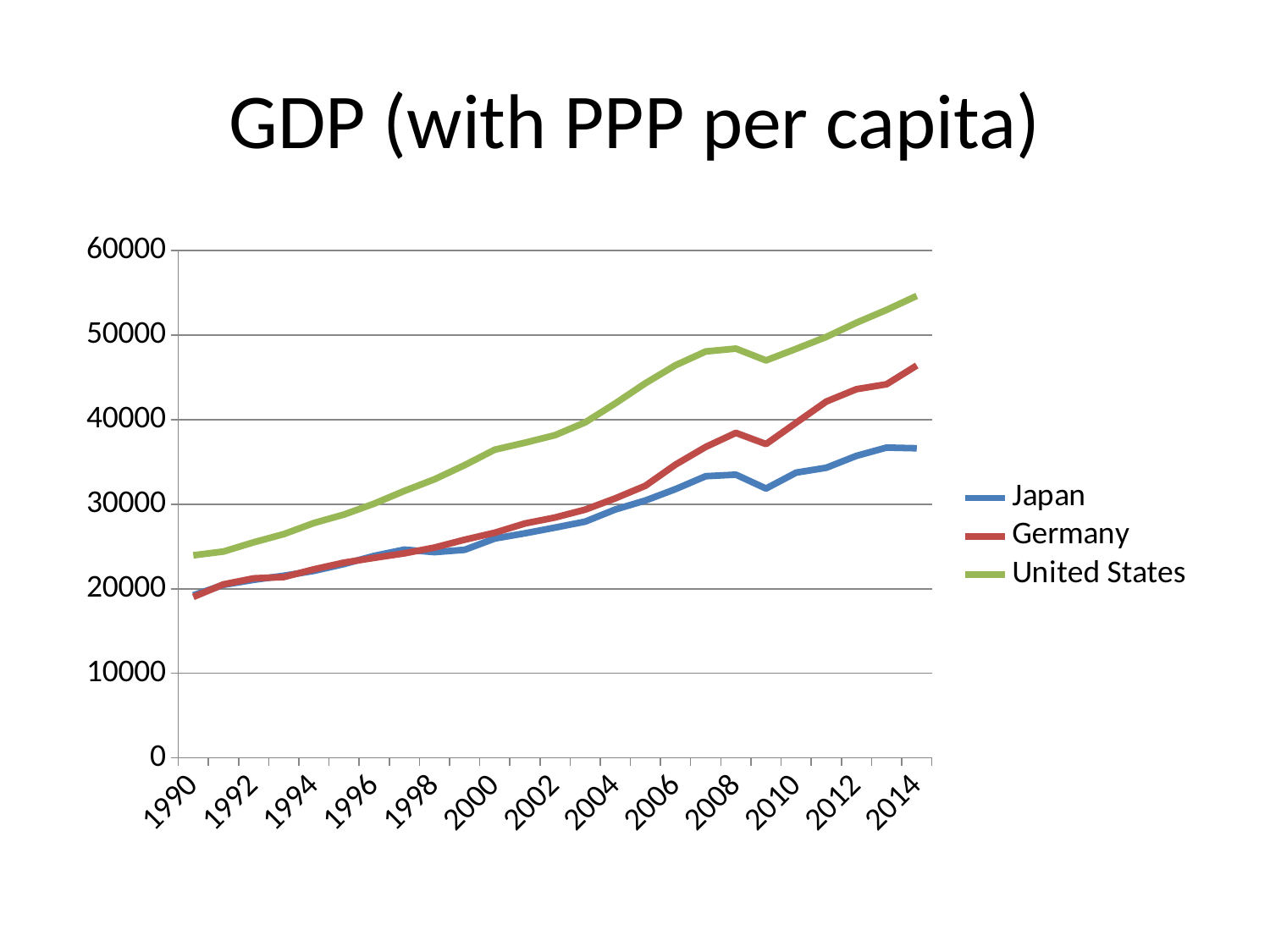
Is the value for United States in 2014 greater or less than 50000? greater Which series is lowest in 2014? Japan Which colour is used for the Japan line? blue Which series is highest in 2014? United States Do the values for United States generally rise or fall from 1990 to 2014? rise How many series does the legend list? 3 What is the title of the chart? GDP (with PPP per capita) Is the value for Japan in 2014 greater or less than 40000? less Is the value for Germany in 2014 greater or less than 40000? greater Which is larger in 2014, the value for Germany or the value for Japan? Germany What kind of chart is shown on the slide? line chart